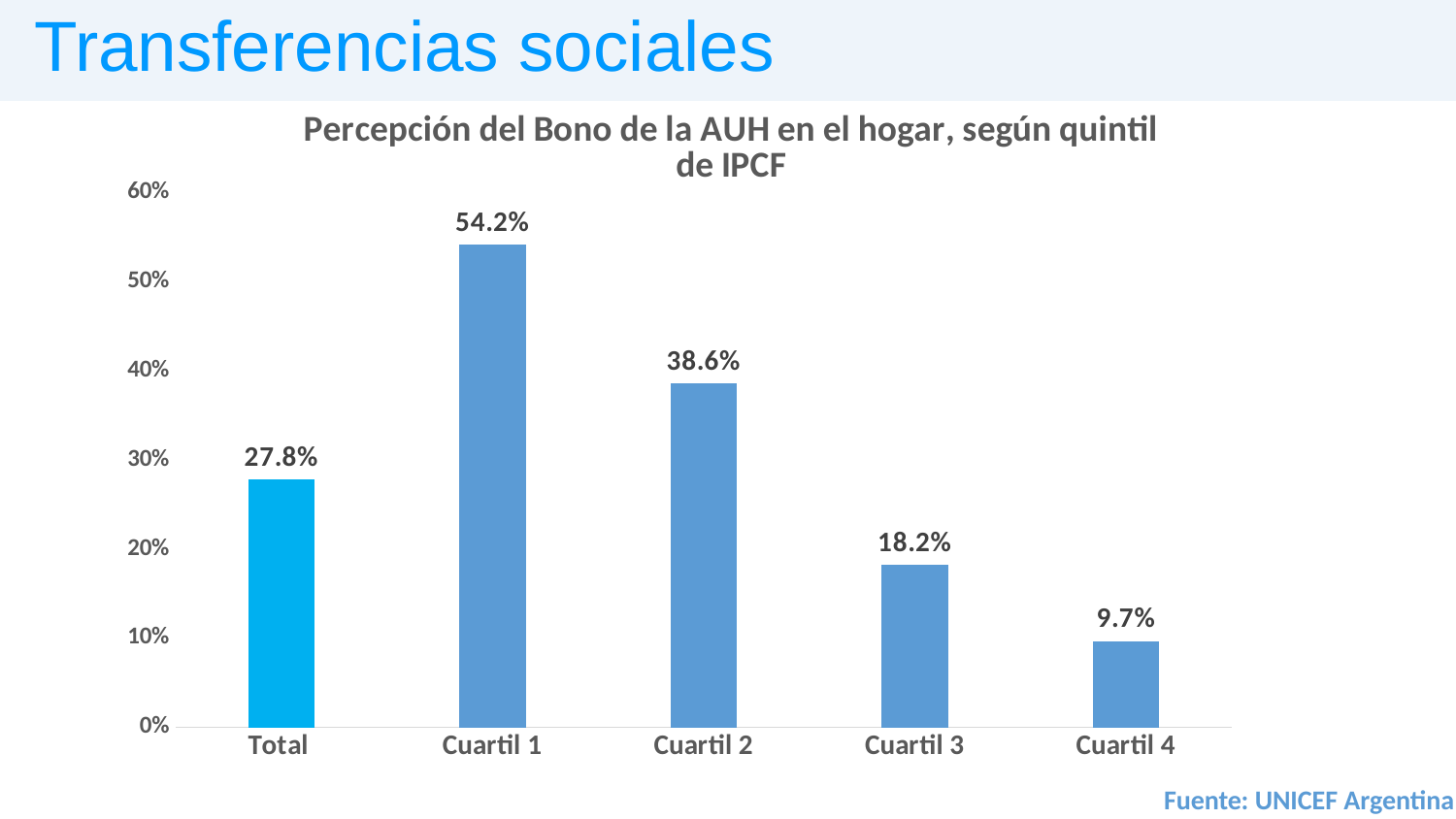
What is the difference between the values for Cuartil 3 and Cuartil 4? 8.5% What is the value for Cuartil 1? 54.2% What is the title of the chart? Percepción del Bono de la AUH en el hogar, según quintil de IPCF What kind of chart is shown on the slide? bar chart What is the difference between the values for Cuartil 1 and Cuartil 2? 15.6% Which is larger, the value for Total or the value for Cuartil 3? Total What is the value for Total? 27.8% What is the value for Cuartil 4? 9.7% Is the value for Cuartil 2 greater or less than 40%? less Which category has the highest value? Cuartil 1 Which category has the lowest value? Cuartil 4 How many categories are shown on the x axis? 5